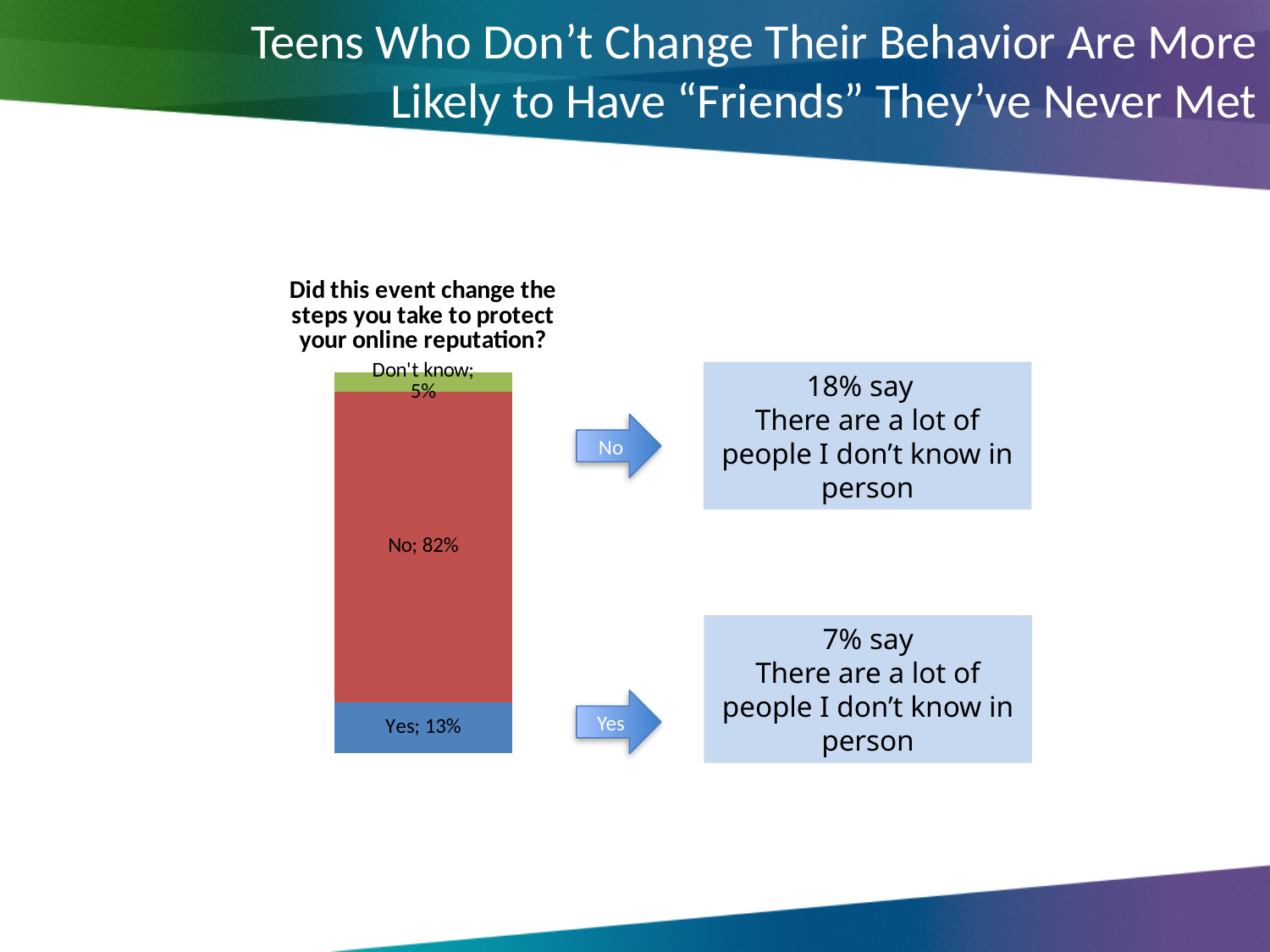
Which response is larger, "Yes" or "Don't know"? Yes Which response has the largest share in the stacked bar chart? No What is the difference in percentage points between the "No" and "Yes" responses? 69 What percentage of teens answered "Don't know" in the stacked bar chart? 5% What is the total of the three segments in the stacked bar? 100% Which response has the smallest share in the stacked bar chart? Don't know What is the difference in percentage points between the "Yes" and "Don't know" responses? 8 What percentage of teens answered "Yes" in the stacked bar chart? 13% What type of chart is shown on the slide? Stacked bar chart What percentage of teens answered "No" to whether the event changed the steps they take to protect their online reputation? 82% What is the title of the chart on the slide? Did this event change the steps you take to protect your online reputation? How many response categories are shown in the stacked bar? 3